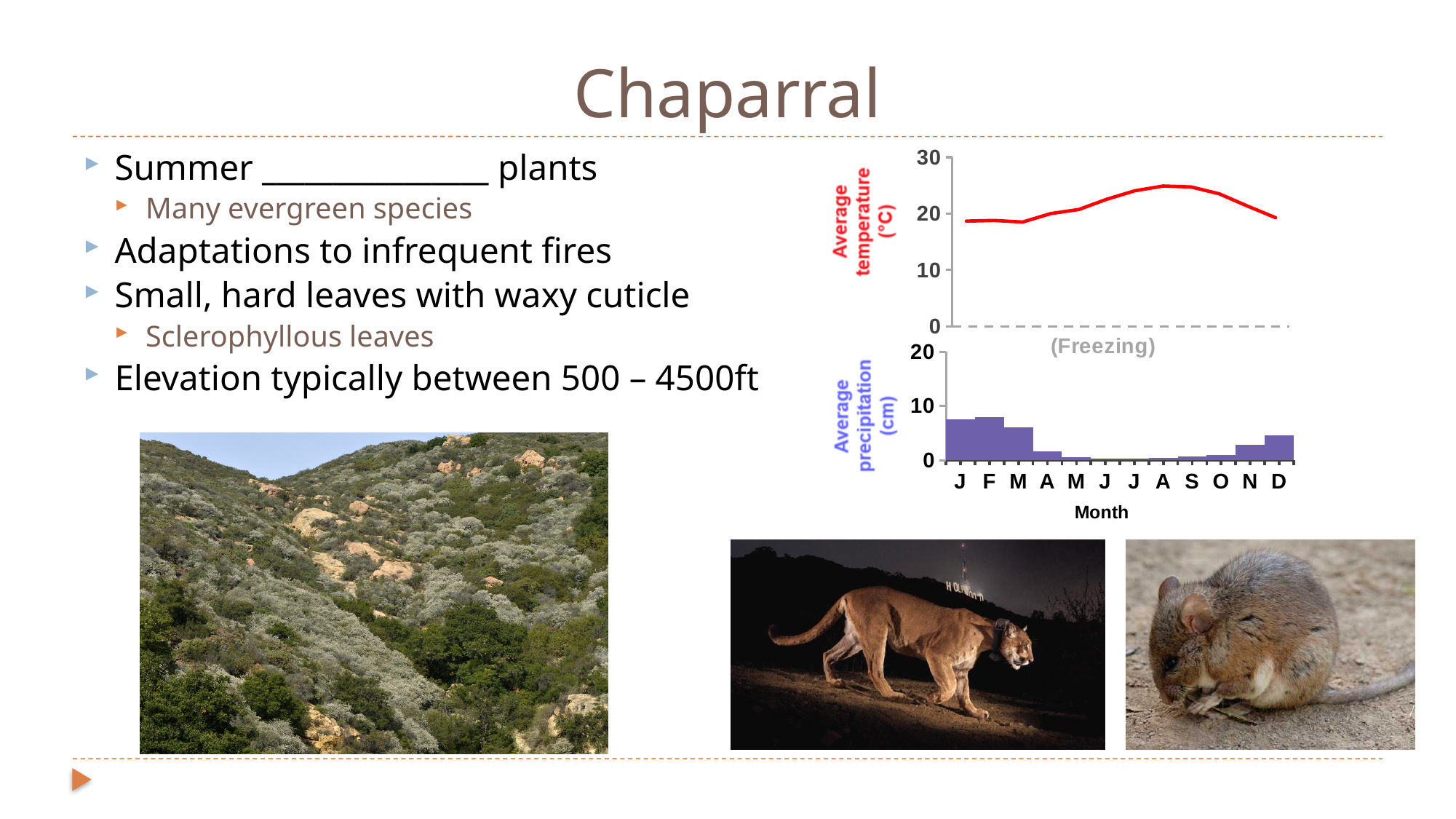
What kind of chart is the upper chart showing average temperature? line chart In the average precipitation chart, is precipitation higher in February or in August? February In the average temperature chart, which month has the highest average temperature? August In the average precipitation chart, does precipitation rise or fall from February to June? fall What label is shown next to the dashed line at 0 on the average temperature chart? (Freezing) In the average temperature chart, is the value for August greater or less than 20? greater In the average precipitation chart, how many months are shown on the x axis? 12 In the average temperature chart, is the value for March greater or less than 10? greater In the average temperature chart, is the temperature higher in August or in January? August What kind of chart is the lower chart showing average precipitation? bar chart In the average precipitation chart, is the value for February greater or less than 10? less In the average temperature chart, does the temperature rise or fall from January to August? rise